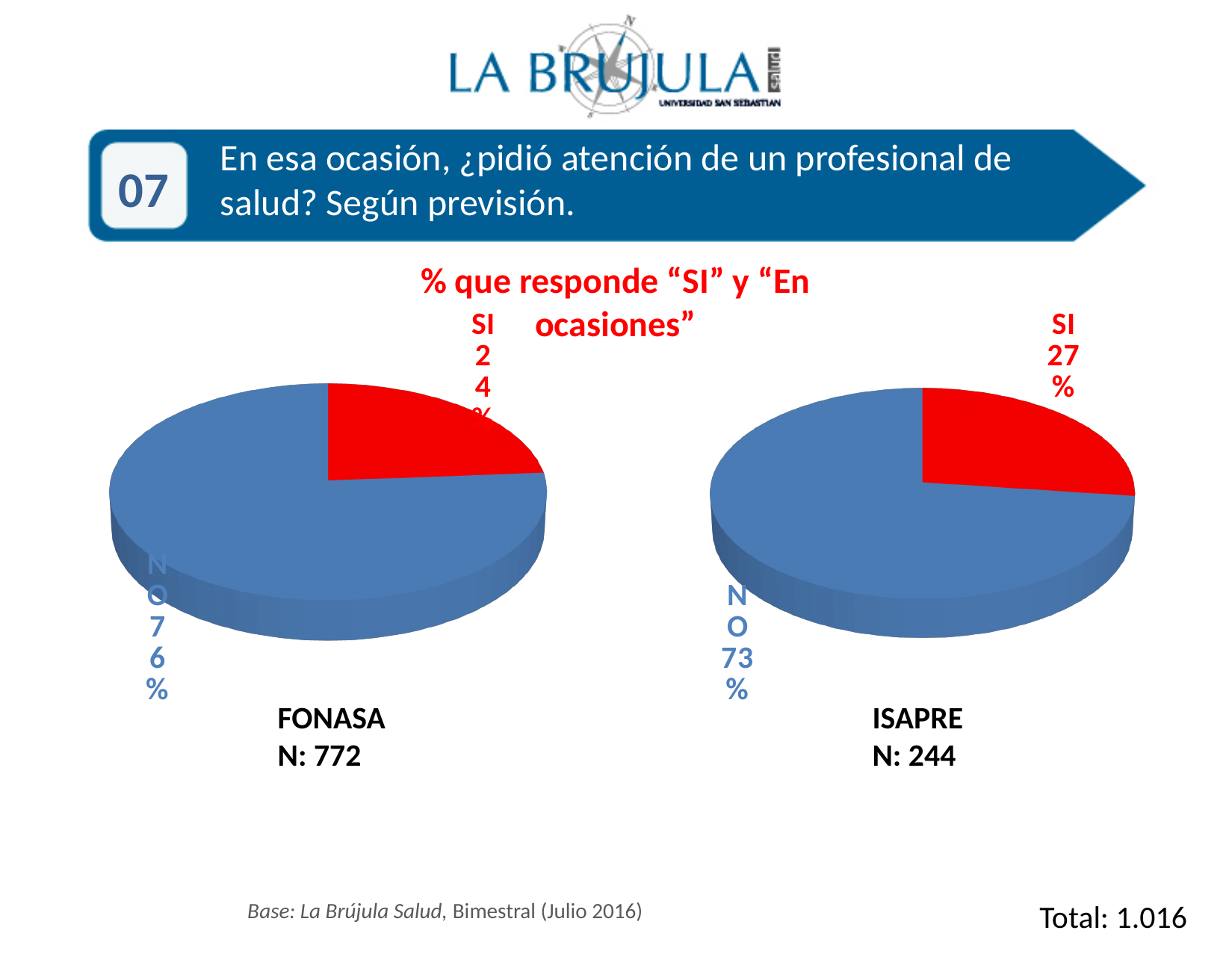
What is the difference between the NO share in the FONASA chart and the NO share in the ISAPRE chart? 3% In the ISAPRE pie chart, what percentage responded SI? 27% In the FONASA pie chart, what percentage responded SI? 24% In the FONASA pie chart, which response has the largest slice? NO How many slices does the ISAPRE pie chart have? 2 In the ISAPRE pie chart, what percentage responded NO? 73% What kind of chart is used for the FONASA data? Pie chart Which is larger: the SI share in the FONASA chart or the SI share in the ISAPRE chart? ISAPRE In the FONASA pie chart, what percentage responded NO? 76% What colour is the SI slice in the ISAPRE pie chart? Red In the ISAPRE pie chart, which response has the smallest slice? SI What is the sample size (N) shown under the FONASA pie chart? 772